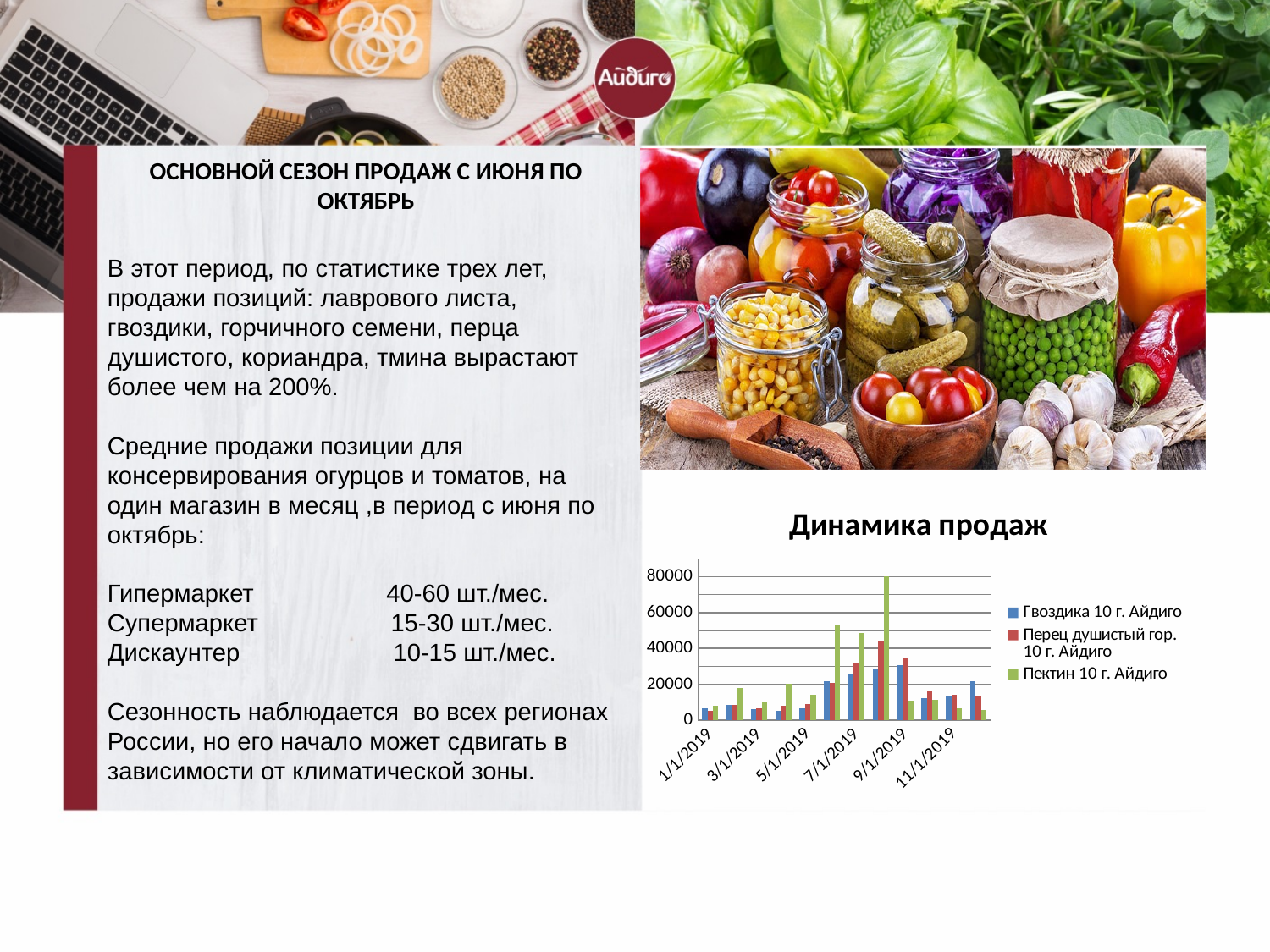
What kind of chart is "Динамика продаж"? bar chart In the "Динамика продаж" chart, which series has the tallest bar overall? Пектин 10 г. Айдиго In the "Динамика продаж" chart, at which date does Пектин 10 г. Айдиго reach its highest value? 9/1/2019 In the "Динамика продаж" chart, is the value for Пектин 10 г. Айдиго at 7/1/2019 greater or less than 40000? greater In the "Динамика продаж" chart, is the value for Гвоздика 10 г. Айдиго at 1/1/2019 greater or less than 20000? less In the "Динамика продаж" chart, is the value for Перец душистый гор. 10 г. Айдиго at 9/1/2019 greater or less than 60000? less Which series in the "Динамика продаж" chart is shown in green? Пектин 10 г. Айдиго In the "Динамика продаж" chart, at 9/1/2019, which is larger: Пектин 10 г. Айдиго or Гвоздика 10 г. Айдиго? Пектин 10 г. Айдиго What is the title of the chart on the slide? Динамика продаж How many series does the legend of the "Динамика продаж" chart list? 3 What is the highest value shown on the y axis of the "Динамика продаж" chart? 80000